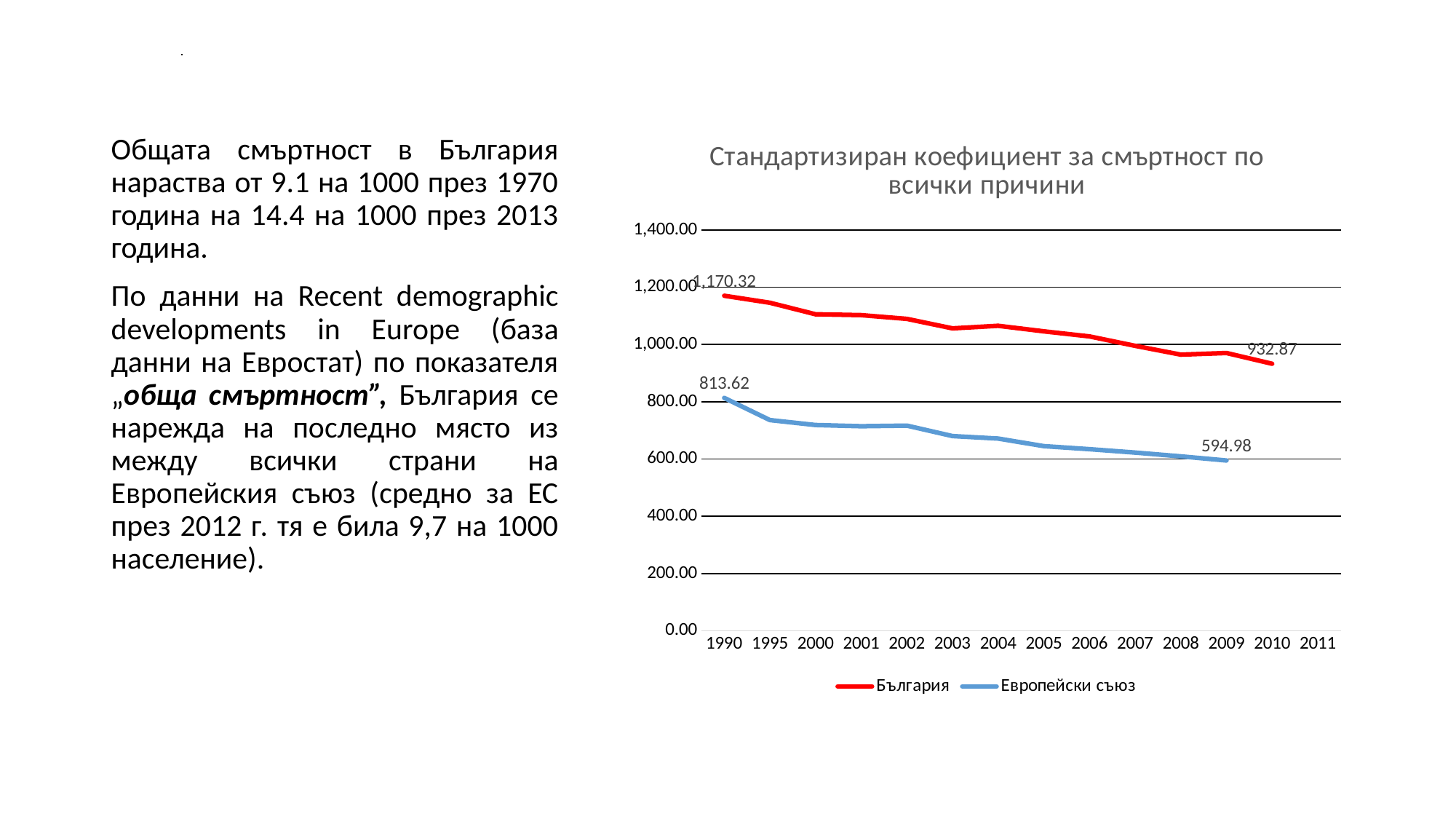
By how much did the България value fall from 1990 to 2010? 237.45 Which series has the higher value in 2005, България or Европейски съюз? България What is the value for България in 1990? 1,170.32 What type of chart is shown on the slide? Line chart Is the value for България in 2000 greater or less than 1,000.00? greater What is the value for Европейски съюз in 2009? 594.98 What is the difference between the България and Европейски съюз values in 1990? 356.70 What is the title of the chart? Стандартизиран коефициент за смъртност по всички причини What is the value for България in 2010? 932.87 What is the value for Европейски съюз in 1990? 813.62 How many series does the legend list? 2 Do the values for Европейски съюз rise or fall from 1990 to 2009? Fall